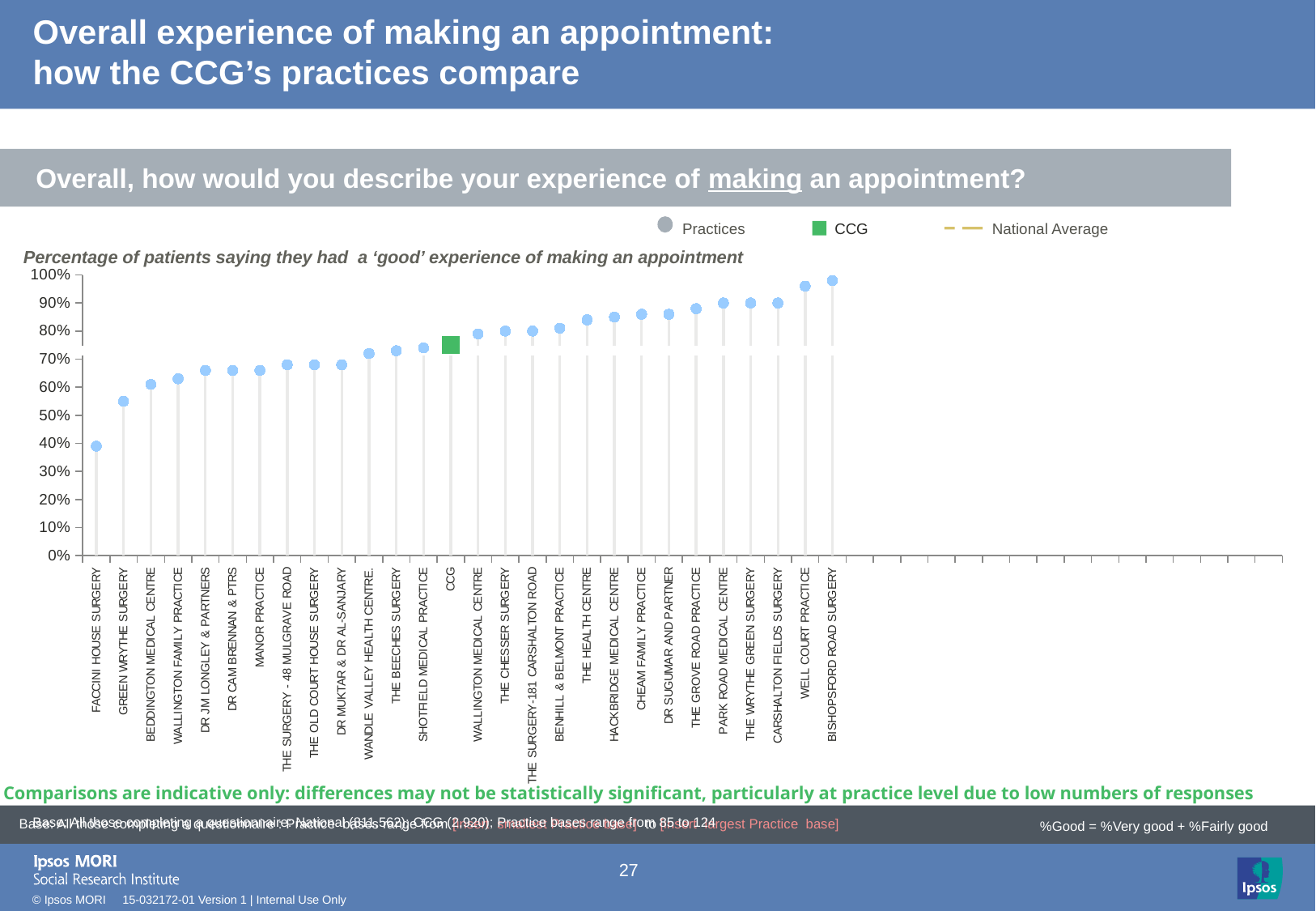
Is the value for BISHOPSFORD ROAD SURGERY greater or less than 90%? greater Is the value for FACCINI HOUSE SURGERY greater or less than 50%? less What colour is the marker used for the CCG in the chart? green Is the value for HACKBRIDGE MEDICAL CENTRE greater or less than 80%? greater Do the values rise or fall moving from left to right along the x axis? rise Which has the higher value, BEDDINGTON MEDICAL CENTRE or PARK ROAD MEDICAL CENTRE? PARK ROAD MEDICAL CENTRE Which practice has the lowest percentage of patients saying they had a good experience of making an appointment? FACCINI HOUSE SURGERY Which practice has the highest percentage of patients saying they had a good experience of making an appointment? BISHOPSFORD ROAD SURGERY Which has the higher value, FACCINI HOUSE SURGERY or GREEN WRYTHE SURGERY? GREEN WRYTHE SURGERY How many entries does the legend list? 3